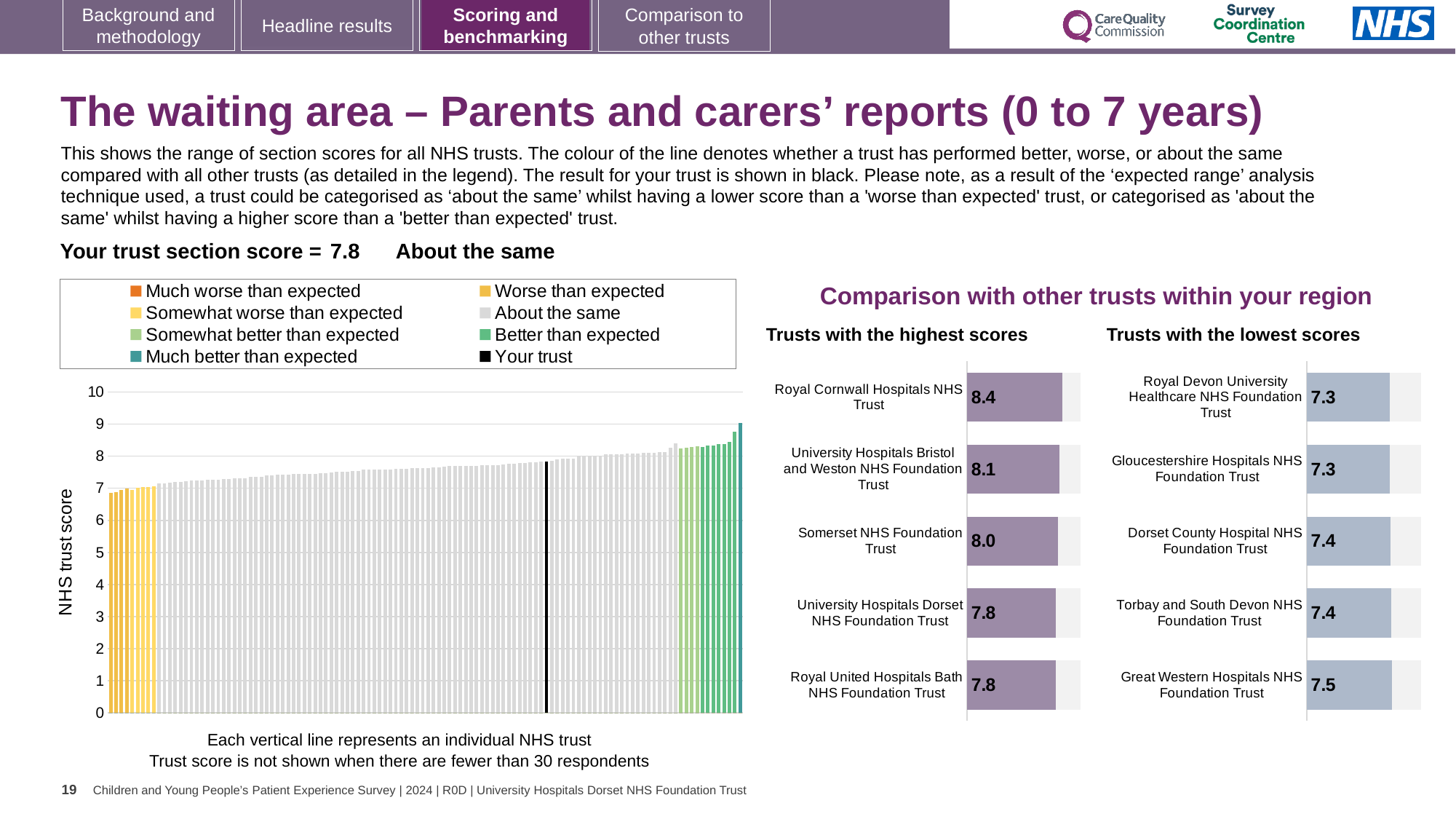
In the 'Trusts with the lowest scores' chart, which trust has the highest score shown? Great Western Hospitals NHS Foundation Trust In the 'Trusts with the lowest scores' chart, what is the difference between the scores of Great Western Hospitals NHS Foundation Trust and Gloucestershire Hospitals NHS Foundation Trust? 0.2 In the 'Trusts with the lowest scores' chart, what is the score for Dorset County Hospital NHS Foundation Trust? 7.4 In the 'Trusts with the lowest scores' chart, what is the score for Great Western Hospitals NHS Foundation Trust? 7.5 In the 'Trusts with the highest scores' chart, which has the larger score: University Hospitals Bristol and Weston NHS Foundation Trust or Somerset NHS Foundation Trust? University Hospitals Bristol and Weston NHS Foundation Trust In the large chart on the left showing all NHS trusts, do the trust scores rise or fall from left to right? rise In the 'Trusts with the highest scores' chart, what is the score for Royal Cornwall Hospitals NHS Trust? 8.4 In the 'Trusts with the highest scores' chart, what is the score for Somerset NHS Foundation Trust? 8.0 In the 'Trusts with the highest scores' chart, which trust has the highest score? Royal Cornwall Hospitals NHS Trust What kind of chart is the large chart on the left showing all NHS trusts? bar chart In the 'Trusts with the highest scores' chart, what is the difference between the scores of Royal Cornwall Hospitals NHS Trust and University Hospitals Dorset NHS Foundation Trust? 0.6 How many trusts are listed in the 'Trusts with the lowest scores' chart? 5